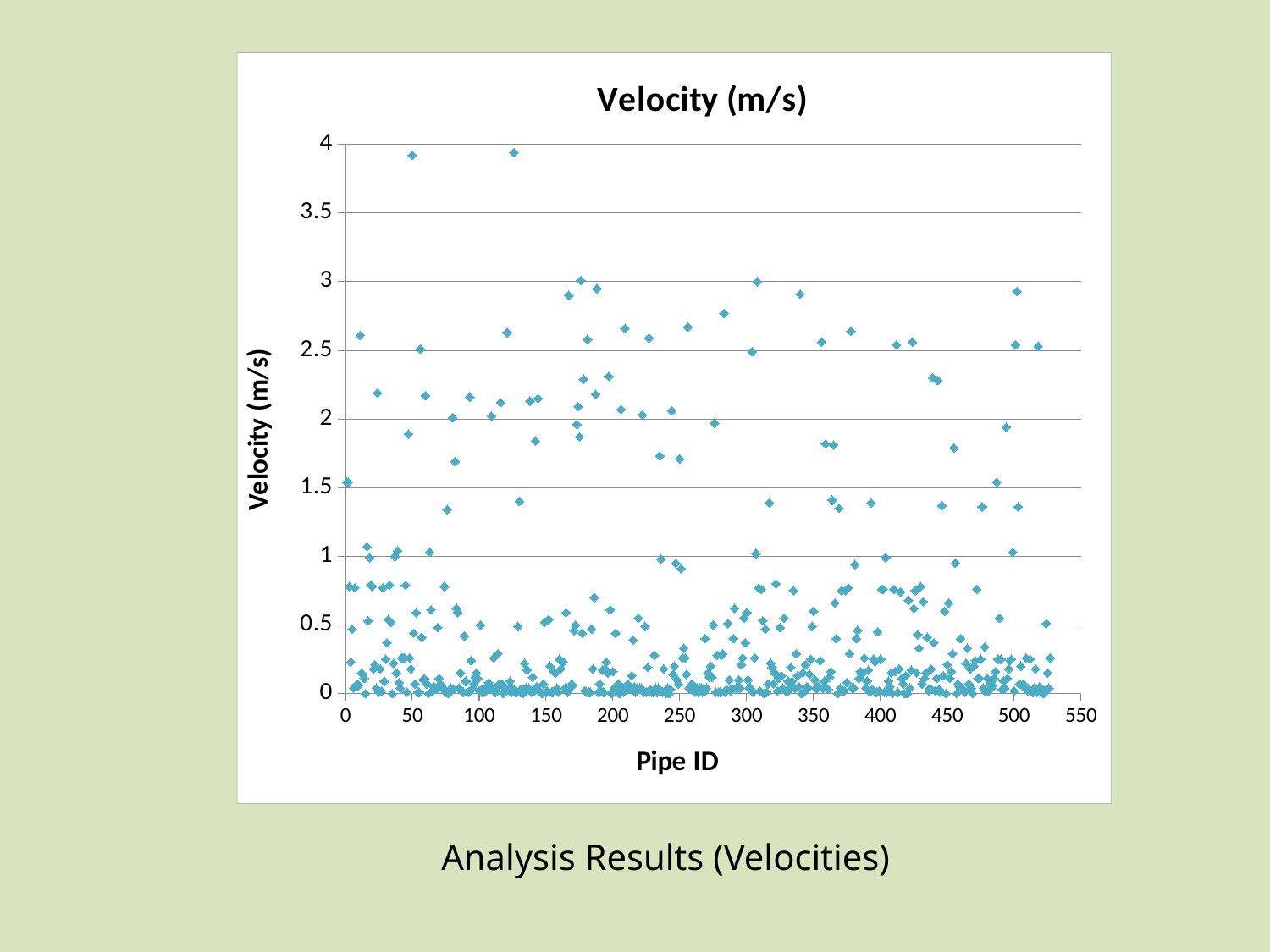
Is the highest velocity plotted on the chart greater or less than 3.5? greater What is the label on the x axis of the chart? Pipe ID What kind of chart is shown on the slide? scatter chart Is the lowest velocity plotted on the chart greater or less than 0.5? less What is the title of the chart? Velocity (m/s) Are the majority of the plotted velocities greater or less than 1? less